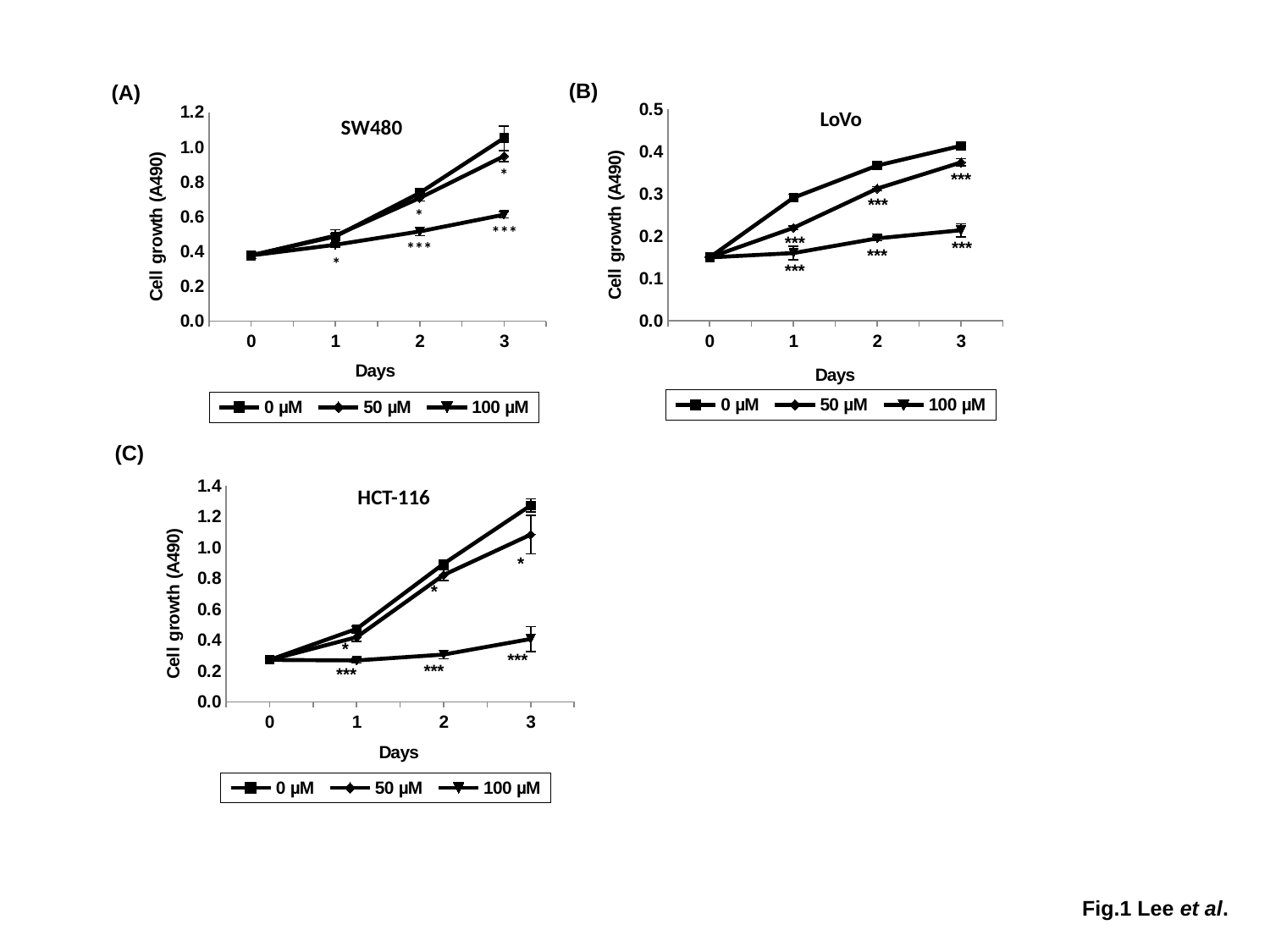
What is the title of the chart labelled (C)? HCT-116 In the LoVo chart, which series has the lowest value at day 3? 100 µM In the HCT-116 chart, is the value for 0 µM at day 3 greater or less than 1.0? greater In the SW480 chart, which is larger at day 3: the value for 0 µM or the value for 100 µM? 0 µM How many series does the legend of the LoVo chart list? 3 In the HCT-116 chart, does the 0 µM series rise or fall from day 0 to day 3? rise What kind of chart is the SW480 chart? line chart In the HCT-116 chart, is the value for 100 µM at day 3 greater or less than 0.6? less In the SW480 chart, is the value for 100 µM at day 3 greater or less than 0.8? less How many time points are plotted along the x axis of the HCT-116 chart? 4